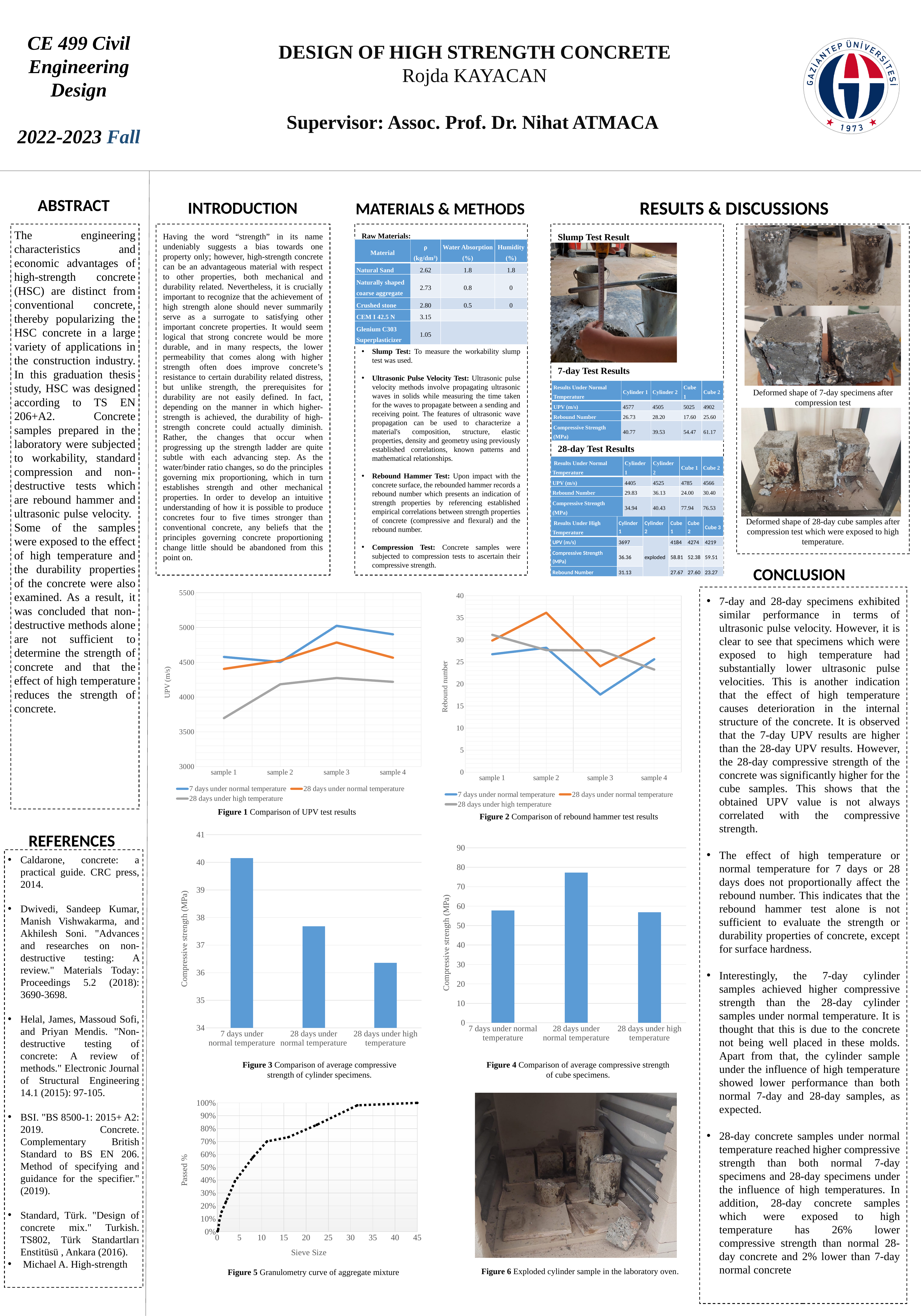
In Figure 2 (Comparison of rebound hammer test results), how many samples are plotted along the x axis? 4 In Figure 3 (Comparison of average compressive strength of cylinder specimens), do the values rise or fall from left to right along the x axis? fall In Figure 1 (Comparison of UPV test results), how many series does the legend list? 3 In Figure 3 (Comparison of average compressive strength of cylinder specimens), which category has the highest compressive strength? 7 days under normal temperature In Figure 1 (Comparison of UPV test results), which sample has the highest UPV for the 7 days under normal temperature series? sample 3 In Figure 1 (Comparison of UPV test results), is the UPV value for sample 1 in the 28 days under high temperature series greater or less than 4000? less In Figure 3 (Comparison of average compressive strength of cylinder specimens), is the value for 28 days under high temperature greater or less than 37? less In Figure 4 (Comparison of average compressive strength of cube specimens), is the value for 28 days under normal temperature greater or less than 70? greater In Figure 1 (Comparison of UPV test results), what kind of chart is shown? line chart In Figure 2 (Comparison of rebound hammer test results), which sample has the highest rebound number for the 28 days under normal temperature series? sample 2